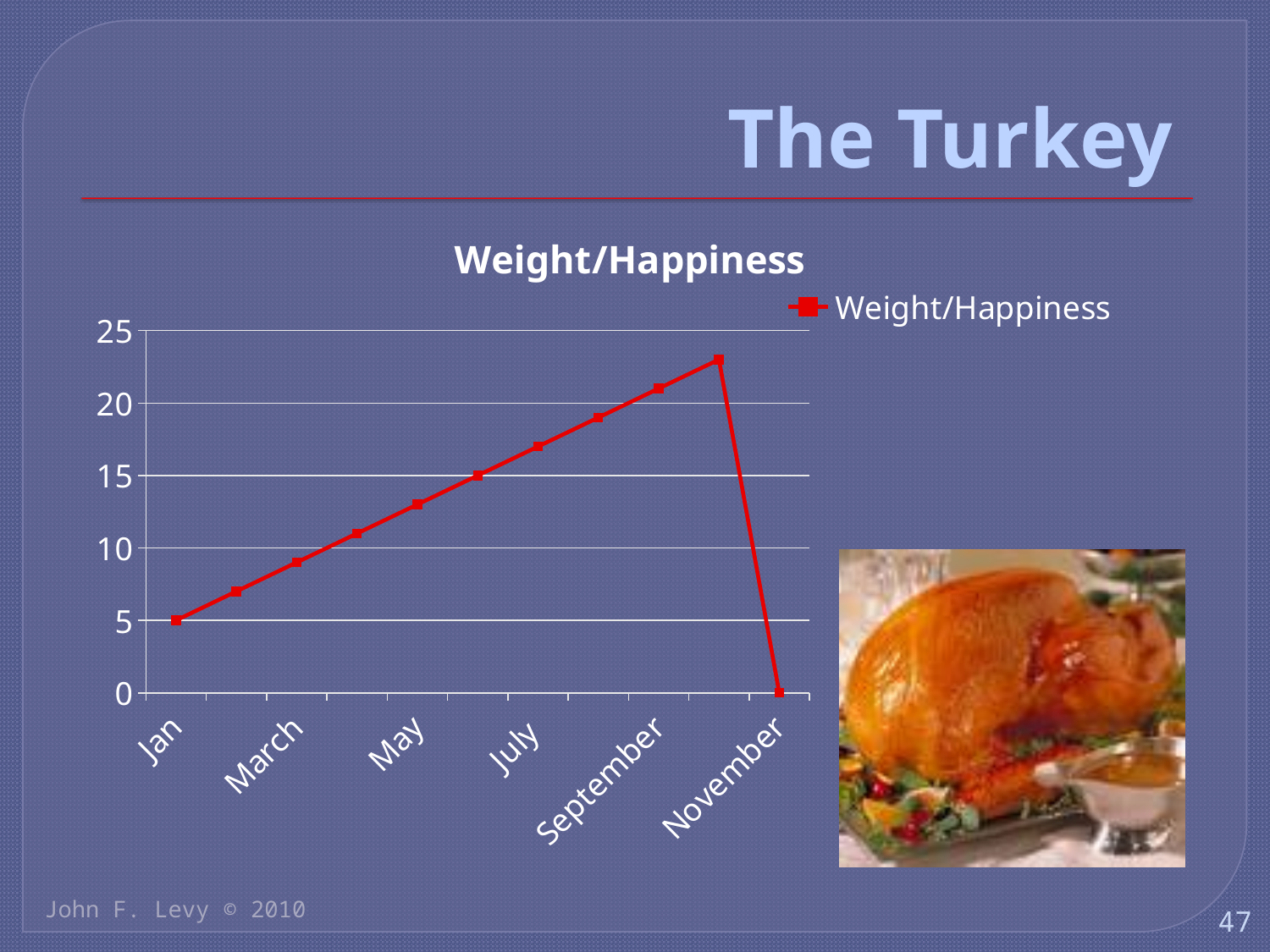
What is the Weight/Happiness value for November? 0 What is the difference between the values for Jan and November? 5 Is the value for September greater or less than 20? greater What kind of chart is shown on the slide? line chart What is the Weight/Happiness value for Jan? 5 Do the values rise or fall from Jan to September? rise Which labeled month has the lowest value? November Which has the larger value, March or September? September Is the value for May greater or less than 10? greater Which has the larger value, Jan or November? Jan Is the value for July greater or less than 20? less How many series does the legend list? 1